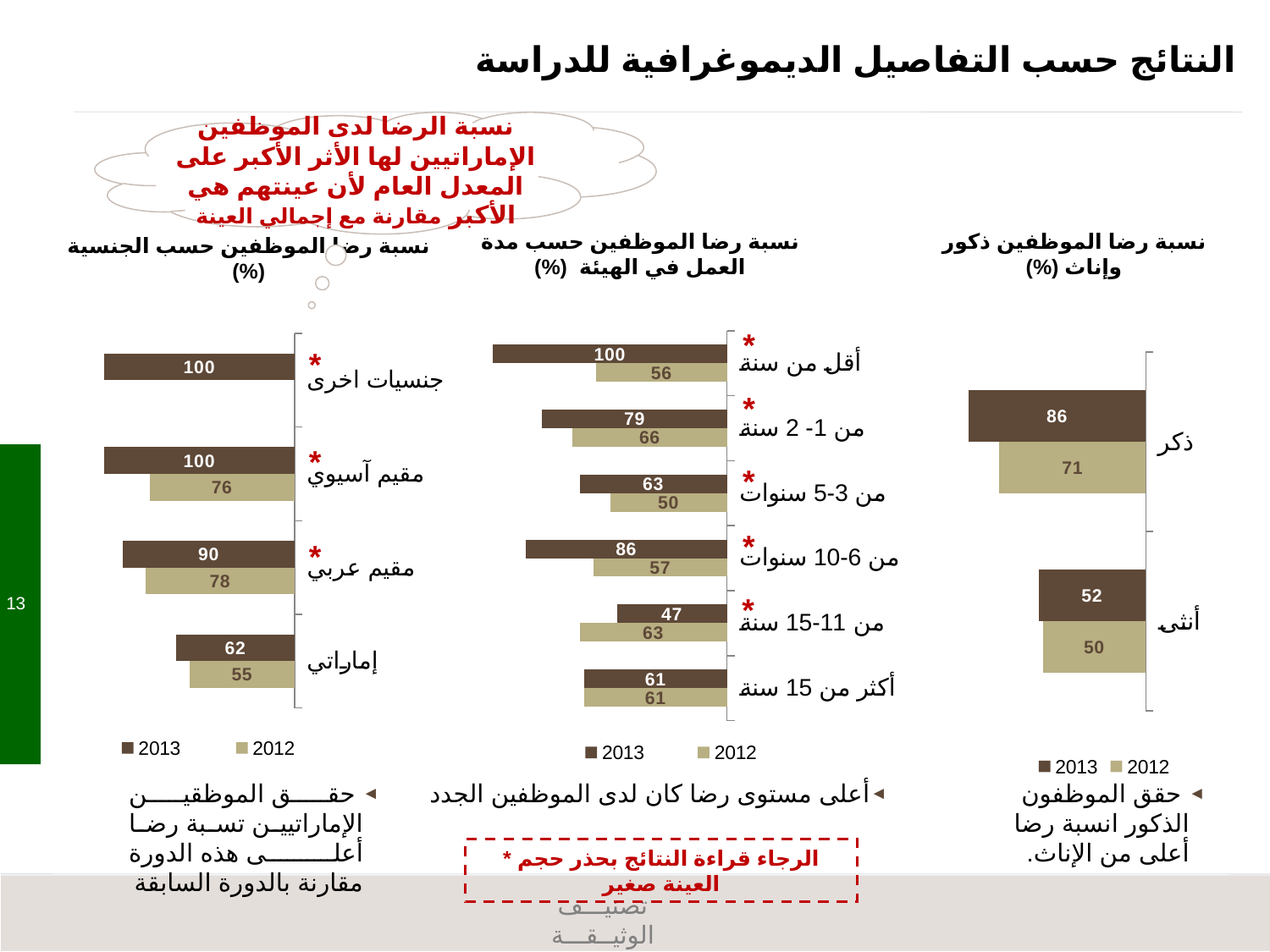
In the chart on the left (satisfaction by nationality), what is the 2012 value for Arab residents (مقيم عربي)? 78 In the chart on the left (satisfaction by nationality), what is the difference between the 2013 and 2012 values for Asian residents (مقيم آسيوي)? 24 In the middle chart (satisfaction by length of service), is the 2013 value for 6-10 years (من 6-10 سنوات) larger or smaller than the 2012 value for the same category? larger In the chart on the right (satisfaction of male and female employees), what is the 2012 value for females (أنثى)? 50 How many series does the legend of the chart on the right (satisfaction of male and female employees) list? 2 In the middle chart (satisfaction by length of service), what is the 2012 value for employees with more than 15 years (أكثر من 15 سنة)? 61 In the chart on the right (satisfaction of male and female employees), what is the 2013 value for males (ذكر)? 86 In the chart on the right (satisfaction of male and female employees), what is the difference between the 2013 and 2012 values for males (ذكر)? 15 In the middle chart (satisfaction by length of service), what is the 2013 value for employees with less than one year (أقل من سنة)? 100 In the middle chart (satisfaction by length of service), which category has the lowest 2013 value? من 11-15 سنة In the middle chart (satisfaction by length of service), how many length-of-service categories are shown? 6 In the chart on the left (satisfaction by nationality), what is the 2013 value for Emiratis (إماراتي)? 62